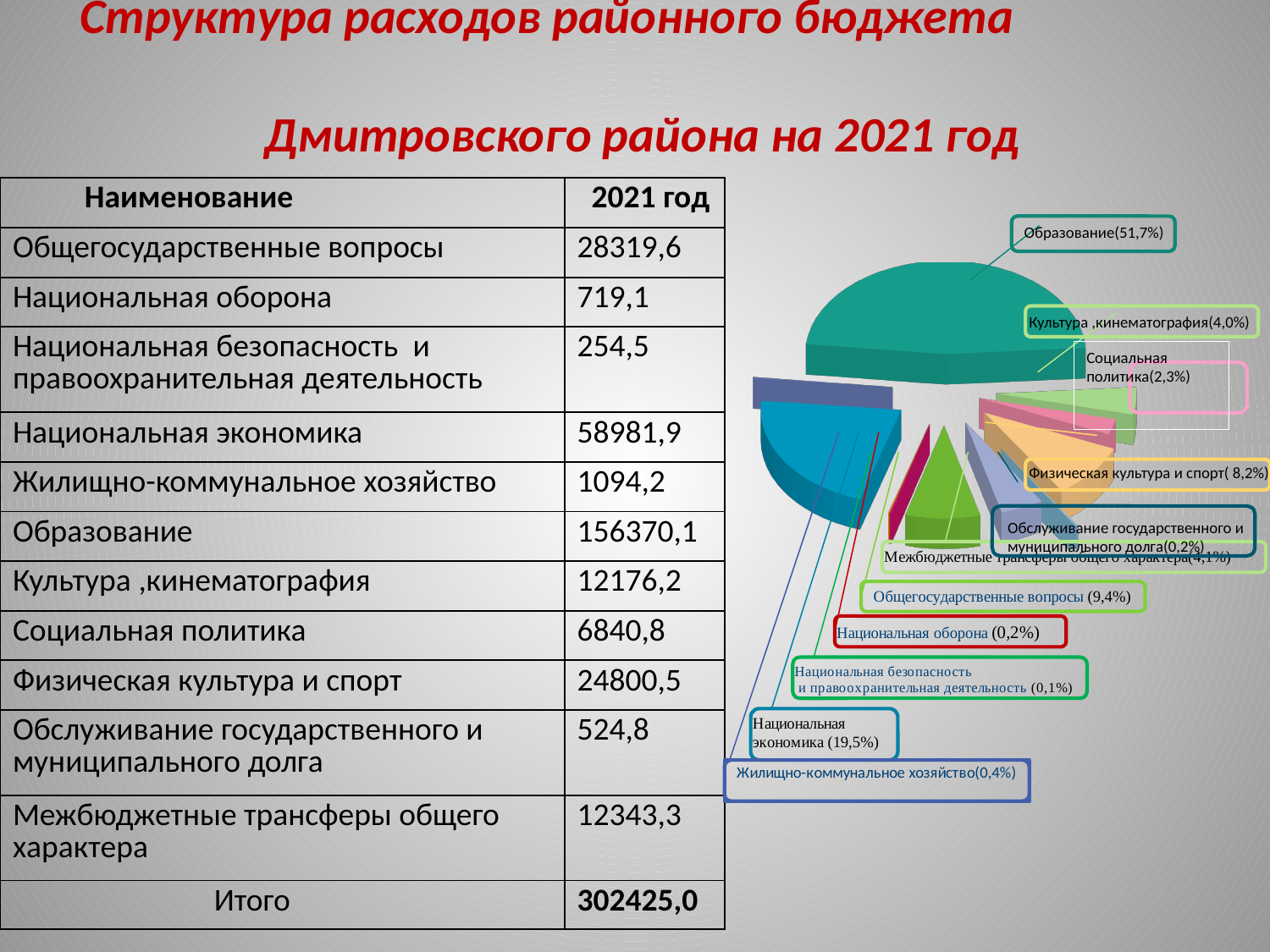
What share of the pie chart does Национальная экономика have? 19,5% What share of the pie chart does Жилищно-коммунальное хозяйство have? 0,4% What share of the pie chart does Образование have? 51,7% By how many percentage points does the share of Образование exceed the share of Национальная экономика in the pie chart? 32,2 Which has a larger share in the pie chart, Национальная экономика or Физическая культура и спорт? Национальная экономика What kind of chart is shown on the slide? pie chart Which category has the largest slice of the pie chart? Образование Which category has the smallest slice of the pie chart? Национальная безопасность и правоохранительная деятельность How many slices does the pie chart have? 11